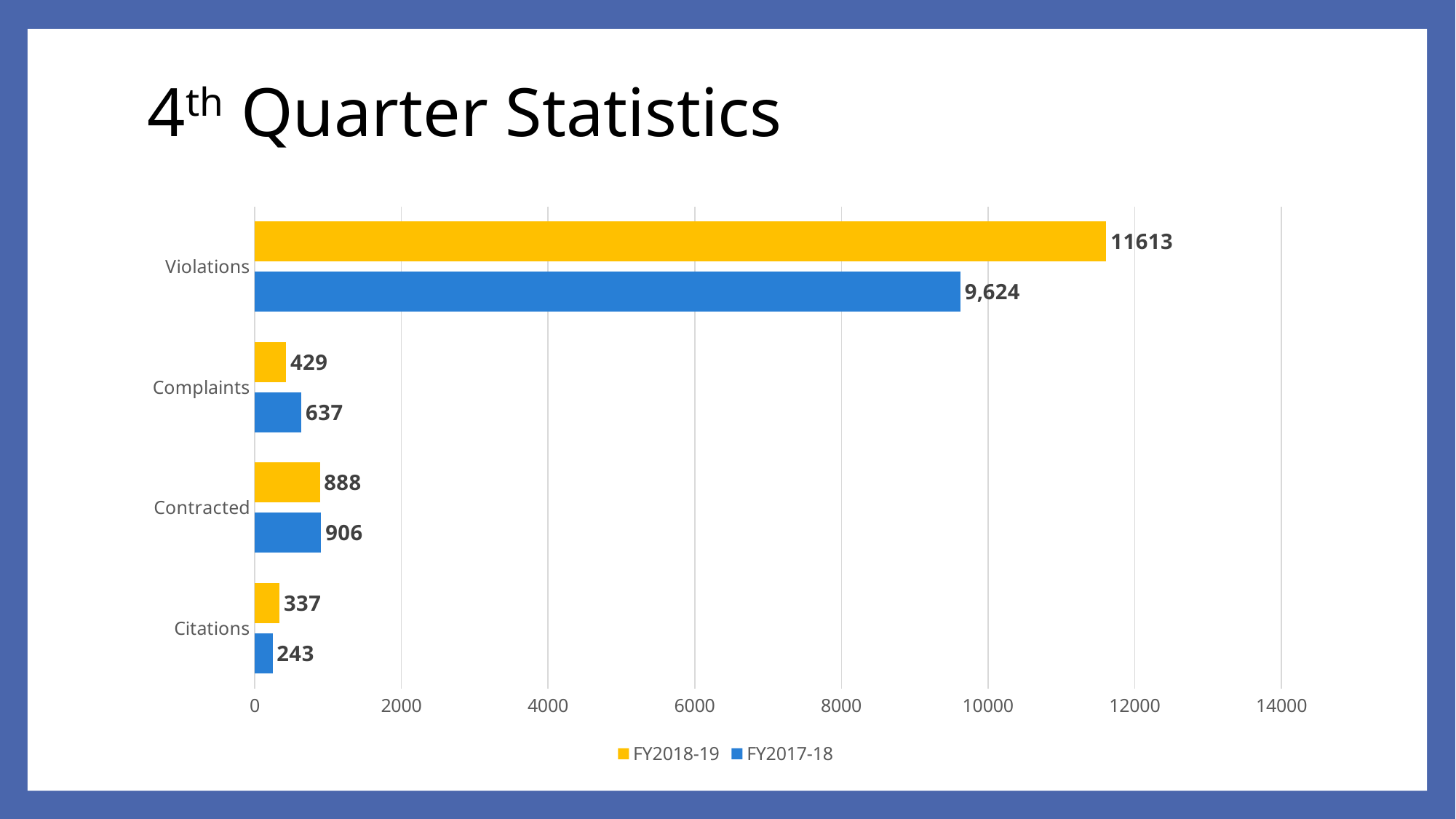
How many series does the legend list? 2 What is the value for Complaints in FY2017-18? 637 Which is larger for Contracted: the FY2018-19 value or the FY2017-18 value? FY2017-18 What is the value for Violations in FY2017-18? 9,624 What is the value for Citations in FY2018-19? 337 How many categories are shown on the chart? 4 Which category has the lowest value in FY2017-18? Citations Which category has the highest value in FY2018-19? Violations Is the FY2018-19 value for Violations greater or less than 10000? greater What type of chart is shown on the slide? Bar chart What is the value for Violations in FY2018-19? 11613 What is the difference between the FY2018-19 and FY2017-18 values for Complaints? 208